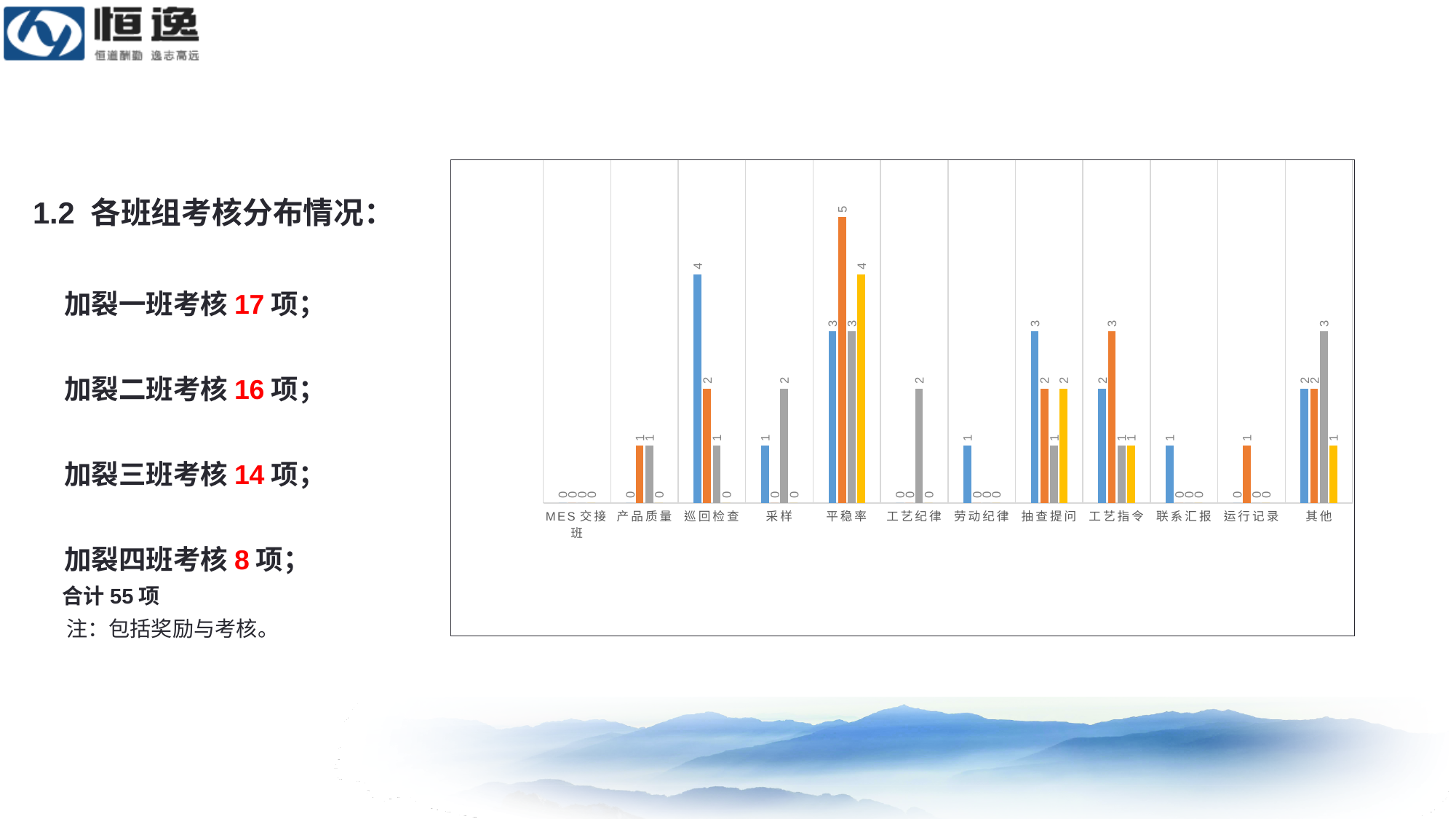
What is the value of the orange bar for 平稳率? 5 How many categories are shown on the x axis of the chart? 12 What is the difference between the orange bar and the blue bar for 平稳率? 2 What is the sum of the four bars for 平稳率? 15 How many differently coloured bar series are plotted for each category? 4 What kind of chart is shown on the slide? bar chart What is the value of the yellow bar for 抽查提问? 2 What is the value of the orange bar for 运行记录? 1 What is the value of the gray bar for 工艺纪律? 2 What is the value of the blue bar for 巡回检查? 4 Which is larger for 其他: the gray bar or the yellow bar? the gray bar Which category has the tallest bar in the chart? 平稳率